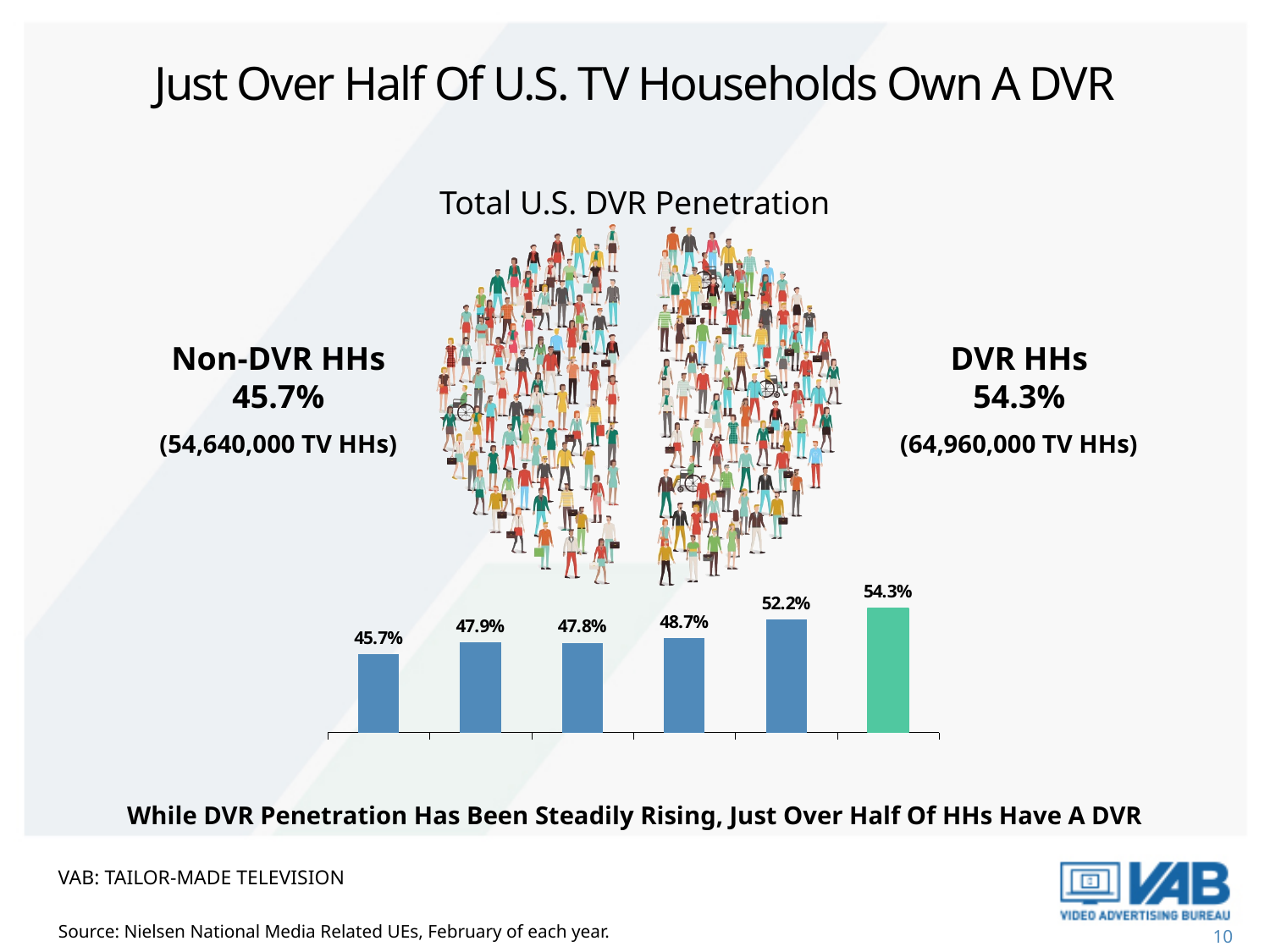
What colour is the last bar in the bar chart, which differs from the others? Green Do the values in the bar chart generally rise or fall from left to right? Rise What is the value shown on the fifth bar of the bar chart? 52.2% How many bars are plotted in the bar chart? 6 What is the value shown on the first (leftmost) bar of the bar chart? 45.7% What kind of chart is shown at the bottom of the slide? Bar chart What percentage of U.S. TV households are Non-DVR HHs according to the slide? 45.7% Which bar in the bar chart has the lowest value? The first bar, 45.7% Which bar in the bar chart has the highest value? The last (green) bar, 54.3% What is the value shown on the last (rightmost, green) bar of the bar chart? 54.3% Which is larger in the bar chart, the fourth bar or the fifth bar? The fifth bar (52.2%) What is the difference between the last bar (54.3%) and the first bar (45.7%) in the bar chart? 8.6 percentage points